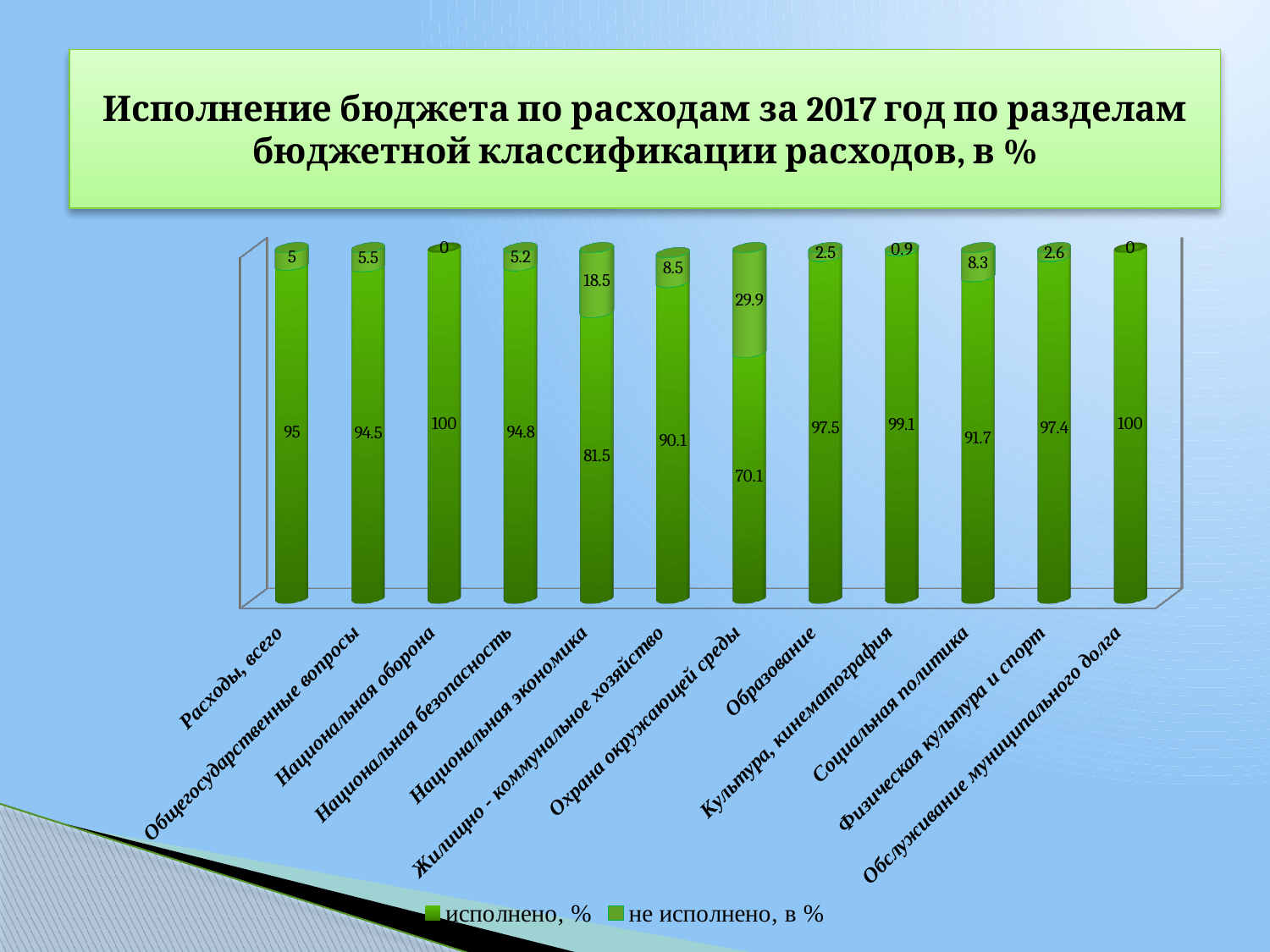
Which category has the highest value of "не исполнено, в %"? Охрана окружающей среды Which category has the lowest value of "исполнено, %"? Охрана окружающей среды How many categories are shown on the x axis? 12 What is the difference between the "исполнено, %" values for Образование and Национальная экономика? 16 What is the value of "исполнено, %" for Культура, кинематография? 99.1 What is the value of "исполнено, %" for Национальная экономика? 81.5 How many series does the legend list? 2 Which is larger, the "исполнено, %" value for Физическая культура и спорт or for Социальная политика? Физическая культура и спорт What is the total of the stacked bar for Национальная безопасность? 100 What kind of chart is shown on the slide? Stacked bar chart What is the value of "не исполнено, в %" for Охрана окружающей среды? 29.9 What is the value of "не исполнено, в %" for Социальная политика? 8.3